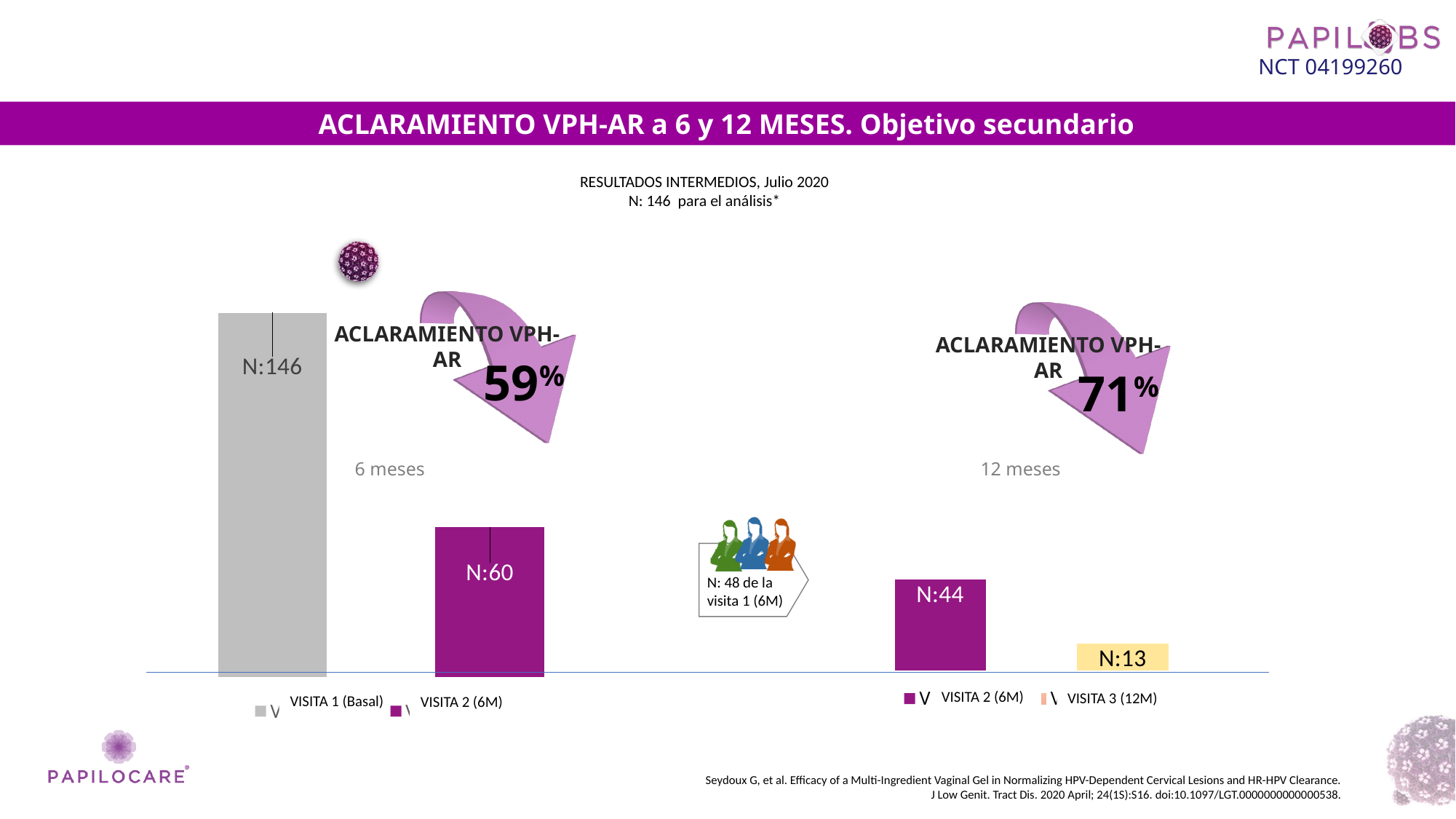
In the left chart (6 meses), what is the difference between the N for VISITA 1 (Basal) and VISITA 2 (6M)? 86 What type of chart is used on this slide? Bar chart In the left chart (6 meses), what is the value shown for VISITA 2 (6M)? N:60 What clearance percentage (ACLARAMIENTO VPH-AR) is shown for 12 meses? 71% Is the N for VISITA 2 (6M) in the left chart larger or smaller than the N for VISITA 2 (6M) in the right chart? larger In the left chart (6 meses), what is the value shown for VISITA 1 (Basal)? N:146 In the right chart (12 meses), which visit has the lowest bar? VISITA 3 (12M) In the left chart (6 meses), which visit has the taller bar? VISITA 1 (Basal) In the right chart (12 meses), what is the value shown for VISITA 2 (6M)? N:44 How many series does the legend of the left chart (6 meses) list? 2 In the right chart (12 meses), what is the difference between the N for VISITA 2 (6M) and VISITA 3 (12M)? 31 In the right chart (12 meses), what is the value shown for VISITA 3 (12M)? N:13